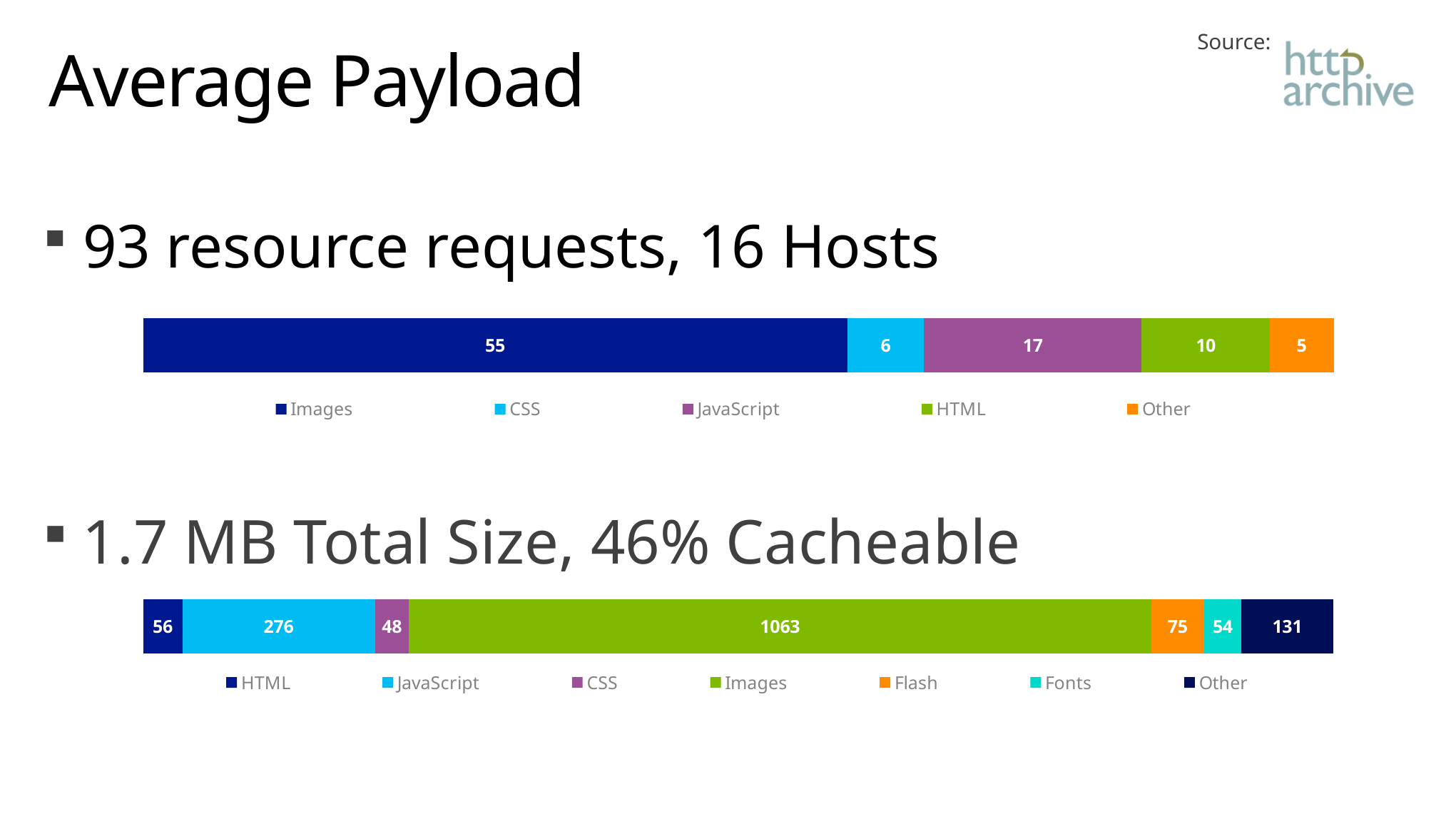
In the bottom chart (total size), what is the value for Fonts? 54 In the bottom chart (total size), which is larger, Flash or Other? Other In the top chart (resource requests), how many segments does the legend list? 5 In the top chart (resource requests), what is the value for JavaScript? 17 In the bottom chart (total size), which segment is the largest? Images In the bottom chart (total size), what is the value for JavaScript? 276 In the top chart (resource requests), what is the difference between the Images and CSS values? 49 In the top chart (resource requests), which segment is the smallest? Other In the top chart (resource requests), what is the value for Images? 55 In the top chart (resource requests), what is the total of all segments in the stacked bar? 93 In the bottom chart (total size), how many segments does the legend list? 7 What kind of chart is used on this slide? Stacked bar chart